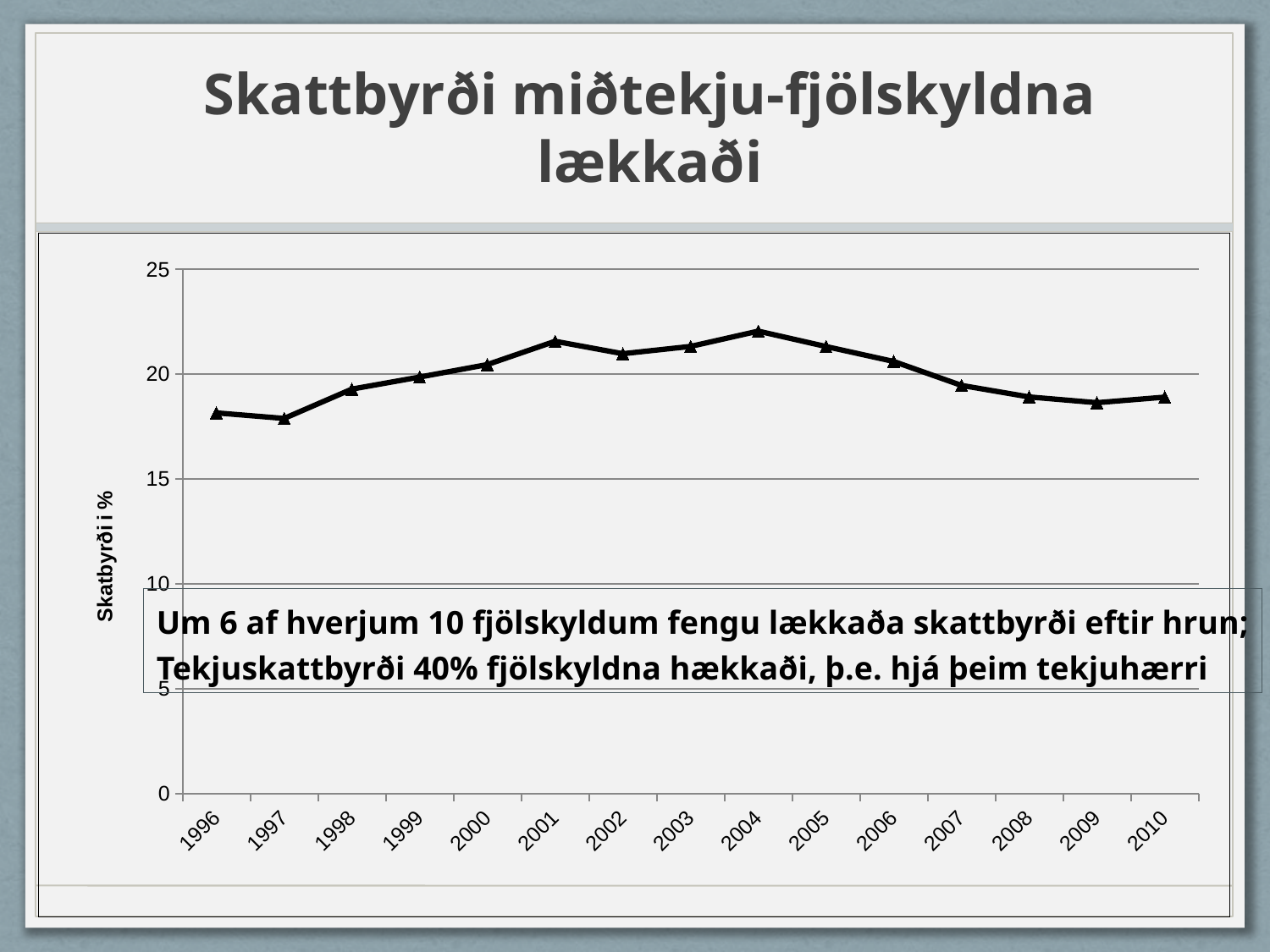
What kind of chart is shown on the slide? line chart Is the value for 1997 greater or less than 15? greater Is the value for 2001 greater or less than 20? greater Is the value for 2009 greater or less than 20? less Which year has the larger value, 2004 or 1996? 2004 Which year has the highest tax burden value in the chart? 2004 Which year has the larger value, 2001 or 2008? 2001 What is the label on the vertical axis of the chart? Skatbyrði i % How many years are plotted along the x axis of the chart? 15 Do the values rise or fall from 2004 to 2009? fall